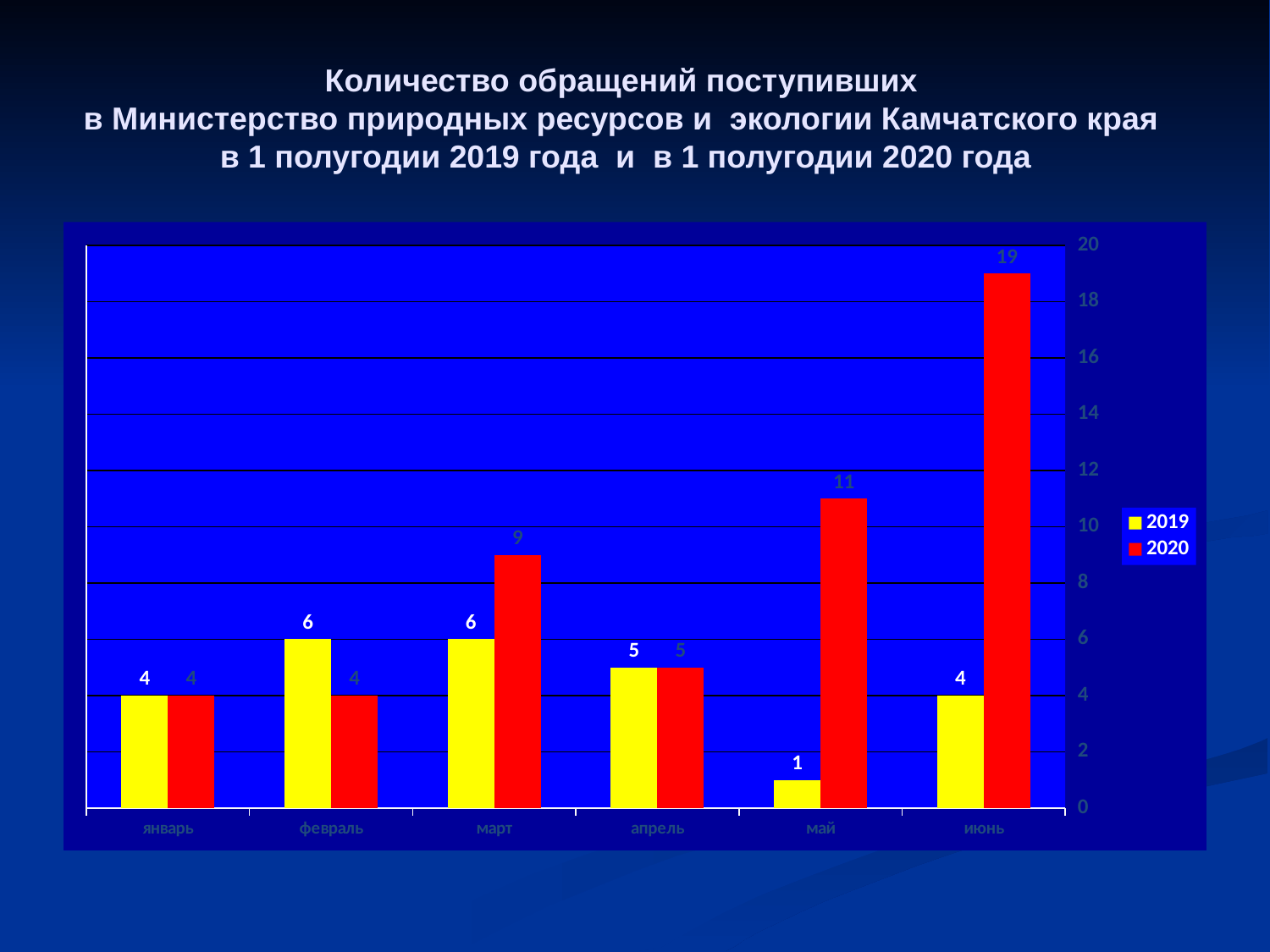
What is the difference between the 2020 and 2019 values in май? 10 How many months are shown on the x axis? 6 How many series does the legend list? 2 What is the value for 2020 in июнь? 19 Which is larger in февраль: the 2019 value or the 2020 value? 2019 Which month has the highest value for the 2020 series? июнь What type of chart is shown on the slide? bar chart Is the value for 2020 in июнь greater or less than 18? greater What is the value for 2019 in май? 1 What is the value for 2020 in март? 9 Which month has the lowest value for the 2019 series? май Which colour represents the 2020 series? red